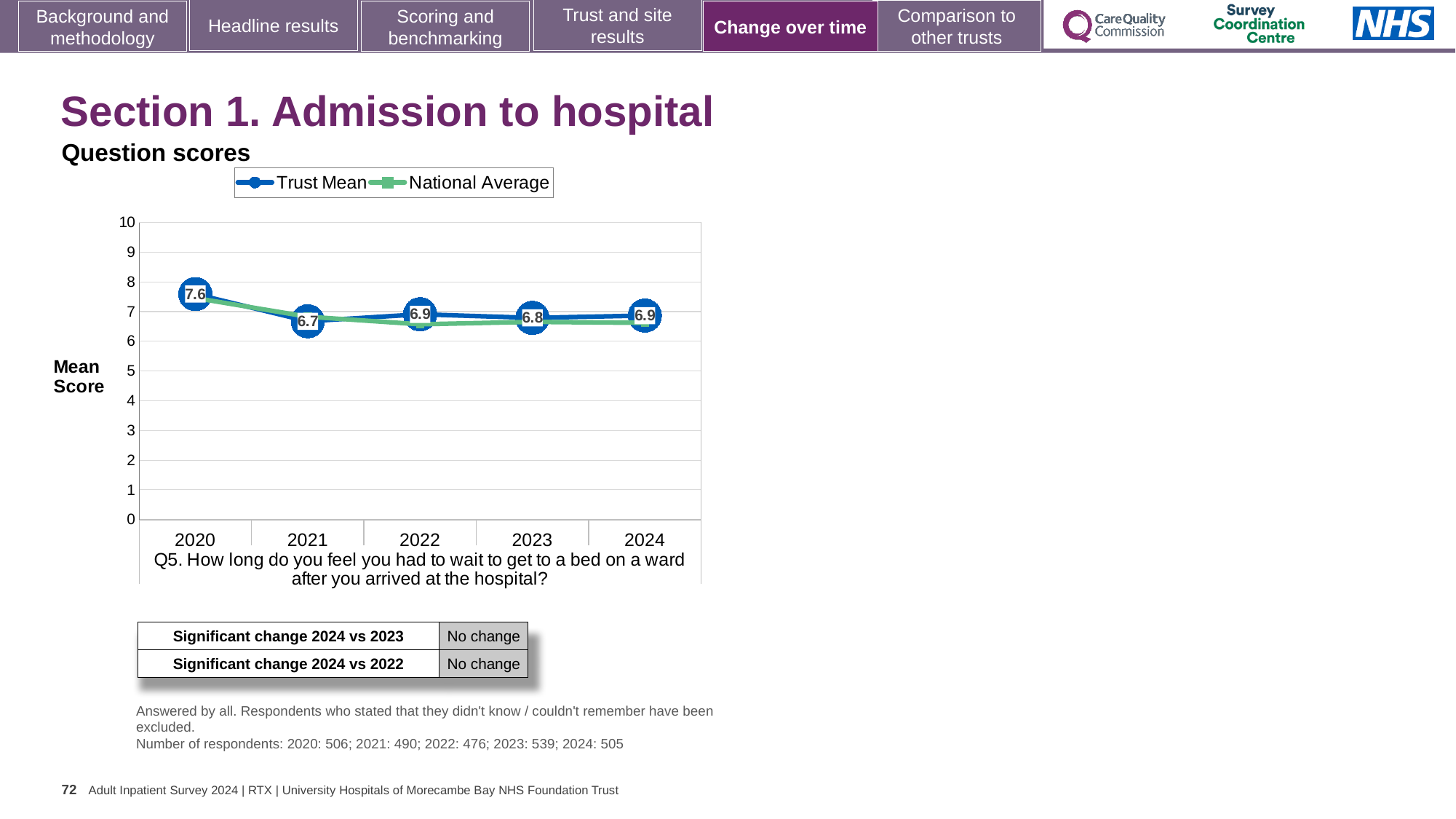
How many years are plotted on the x axis? 5 What is the Trust Mean score for 2024? 6.9 Does the Trust Mean score rise or fall from 2020 to 2021? Fall What is the Trust Mean score for 2020? 7.6 What is the difference between the Trust Mean scores for 2020 and 2021? 0.9 In which year is the Trust Mean score lowest? 2021 Which year has the larger Trust Mean score, 2020 or 2024? 2020 In which year is the Trust Mean score highest? 2020 Is the National Average value for 2020 greater or less than 7? greater How many series does the legend list? 2 What is the Trust Mean score for 2021? 6.7 What kind of chart is shown? Line chart